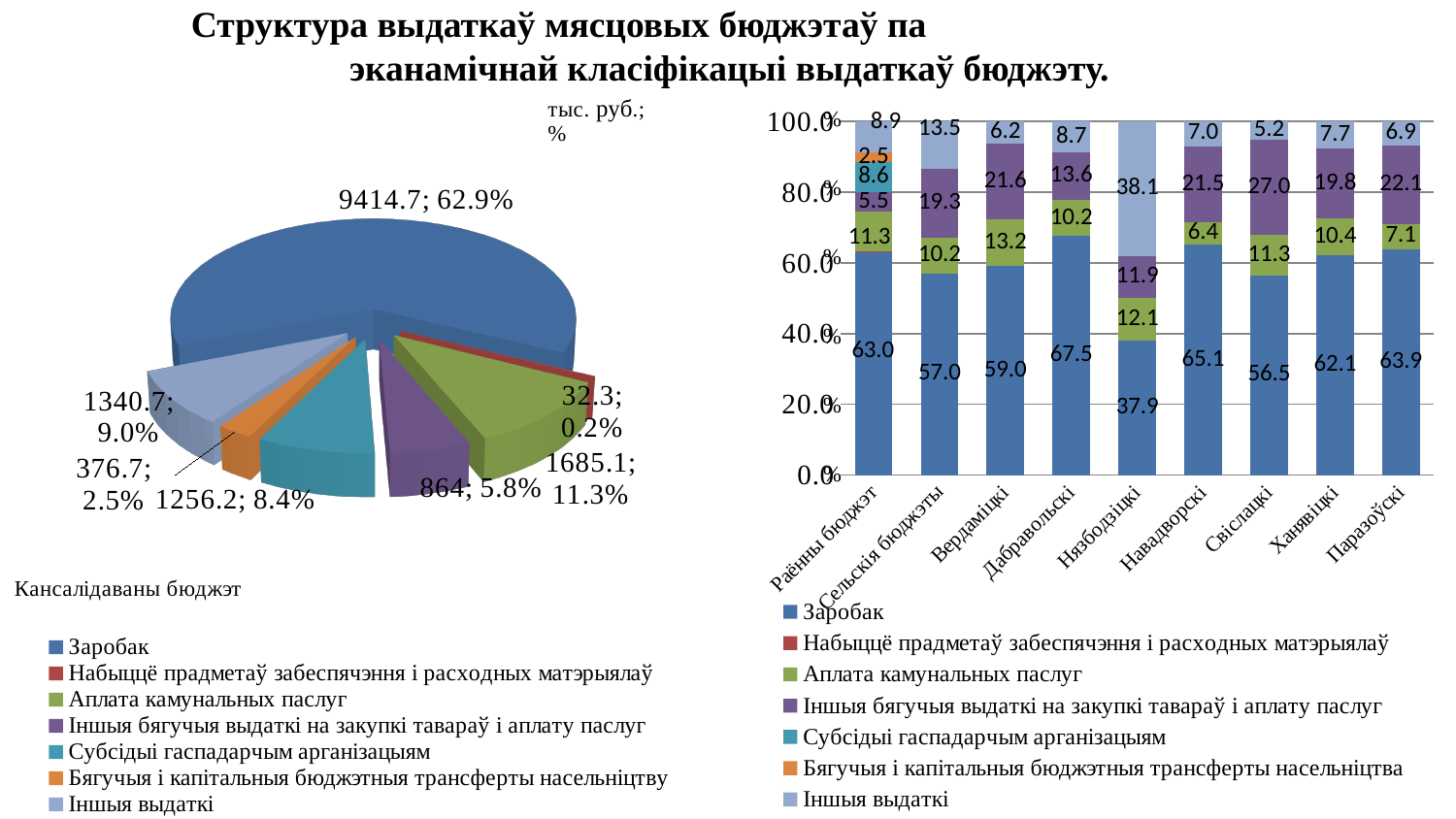
In the pie chart on the left, what value and share are shown for the Заробак slice? 9414.7; 62.9% What type of chart is the chart on the left? Pie chart In the pie chart on the left, how many slices are there? 7 In the stacked bar chart on the right, how many series does the legend list? 7 In the stacked bar chart on the right, which category has the highest Заробак value? Дабравольскі In the stacked bar chart on the right, what is the Заробак value for Нязбодзіцкі? 37.9 In the stacked bar chart on the right, what is the difference between the Заробак values for Дабравольскі and Сельскія бюджэты? 10.5 In the pie chart on the left, what is the value shown for Іншыя выдаткі? 1340.7 In the stacked bar chart on the right, how many categories are shown on the x axis? 9 In the pie chart on the left, which category has the smallest slice? Набыццё прадметаў забеспячэння і расходных матэрыялаў In the stacked bar chart on the right, what is the Іншыя выдаткі value for Нязбодзіцкі? 38.1 In the pie chart on the left, what share does the Аплата камунальных паслуг slice have? 11.3%